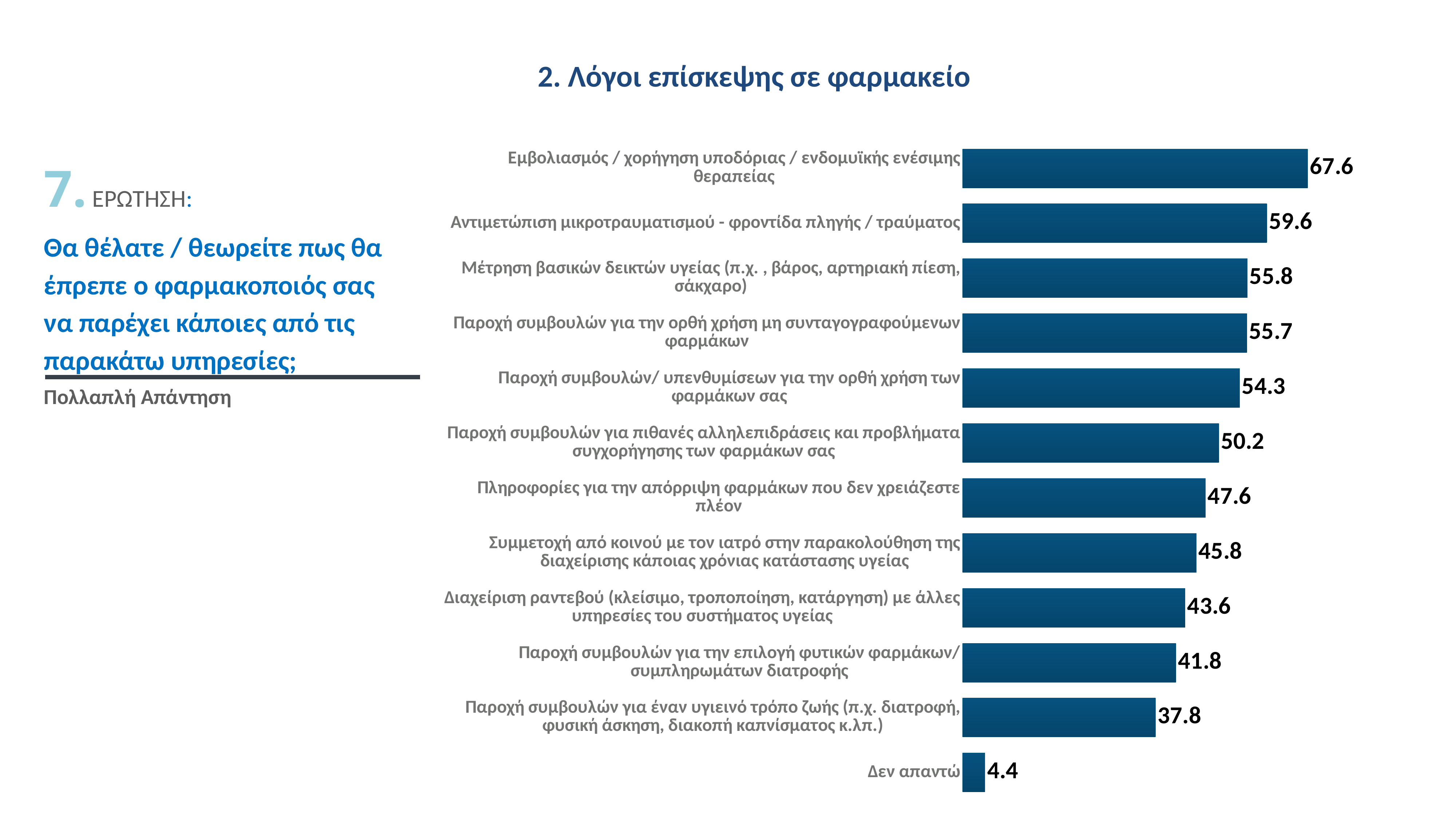
Which category has the highest value? Εμβολιασμός / χορήγηση υποδόριας / ενδομυϊκής ενέσιμης θεραπείας What is the title of the chart? 2. Λόγοι επίσκεψης σε φαρμακείο What is the value for "Παροχή συμβουλών για πιθανές αλληλεπιδράσεις και προβλήματα συγχορήγησης των φαρμάκων σας"? 50.2 Which is larger: the value for "Συμμετοχή από κοινού με τον ιατρό στην παρακολούθηση της διαχείρισης κάποιας χρόνιας κατάστασης υγείας" or for "Διαχείριση ραντεβού (κλείσιμο, τροποποίηση, κατάργηση) με άλλες υπηρεσίες του συστήματος υγείας"? Συμμετοχή από κοινού με τον ιατρό στην παρακολούθηση της διαχείρισης κάποιας χρόνιας κατάστασης υγείας What is the difference between the values for "Παροχή συμβουλών για την επιλογή φυτικών φαρμάκων/ συμπληρωμάτων διατροφής" and "Παροχή συμβουλών για έναν υγιεινό τρόπο ζωής (π.χ. διατροφή, φυσική άσκηση, διακοπή καπνίσματος κ.λπ.)"? 4.0 How many categories are shown in the chart? 12 Which category has the lowest value? Δεν απαντώ What is the value for "Πληροφορίες για την απόρριψη φαρμάκων που δεν χρειάζεστε πλέον"? 47.6 What kind of chart is shown on the slide? Bar chart What is the value for "Δεν απαντώ"? 4.4 What is the difference between the values for "Εμβολιασμός / χορήγηση υποδόριας / ενδομυϊκής ενέσιμης θεραπείας" and "Αντιμετώπιση μικροτραυματισμού - φροντίδα πληγής / τραύματος"? 8.0 What is the value for "Εμβολιασμός / χορήγηση υποδόριας / ενδομυϊκής ενέσιμης θεραπείας"? 67.6